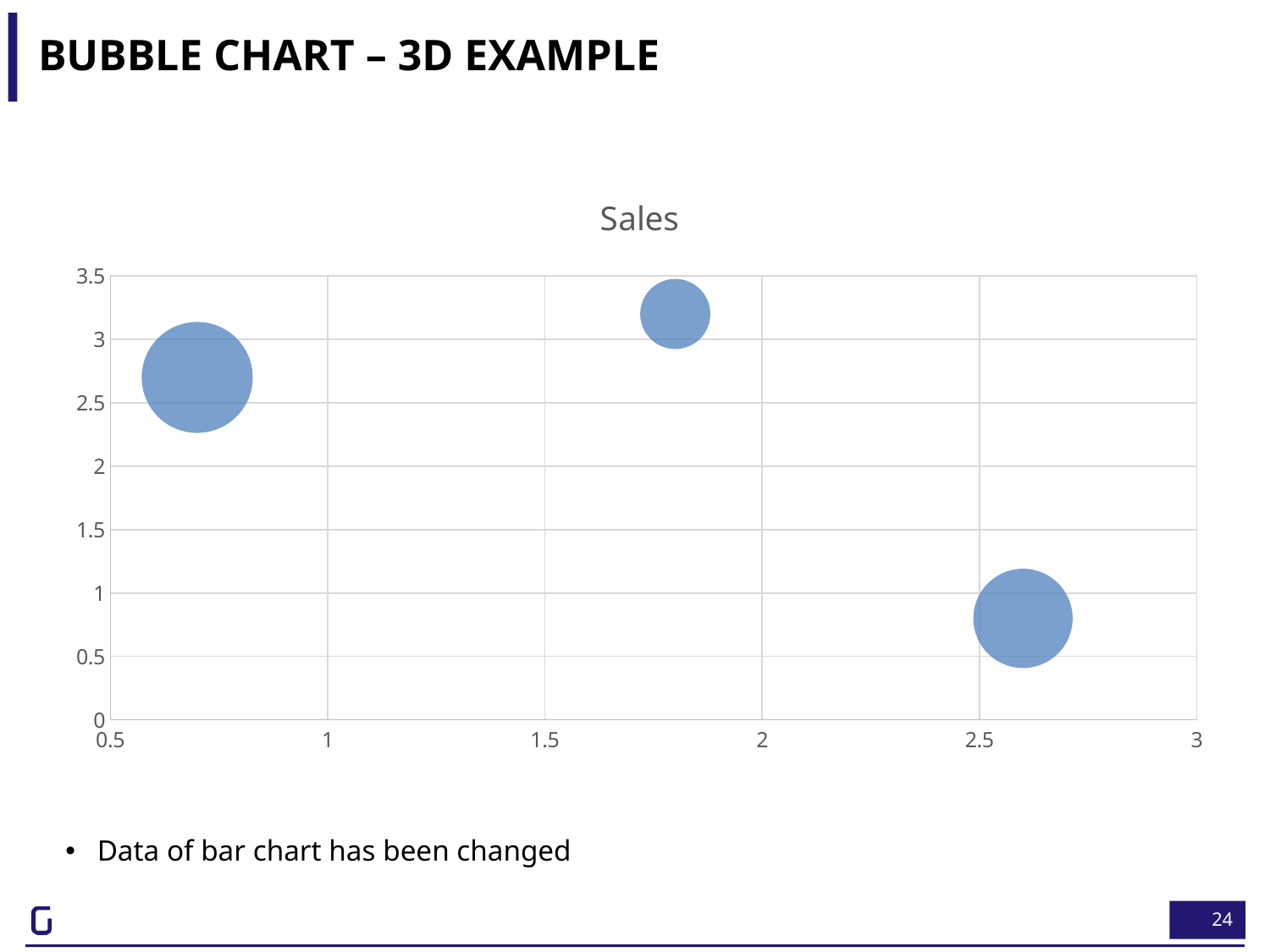
Which bubble is larger in size, the leftmost bubble or the middle bubble? The leftmost bubble Is the x-axis value of the leftmost bubble greater or less than 1? less Is the y-axis value of the topmost bubble greater or less than 3? greater How many bubbles are plotted on the chart? 3 What is the highest value shown on the y-axis? 3.5 Which bubble has the lowest y-axis value: the leftmost, the middle, or the rightmost? The rightmost What is the title of the chart? Sales What kind of chart is shown on the slide? Bubble chart Is the x-axis value of the rightmost bubble greater or less than 2.5? greater Which bubble has the highest y-axis value: the leftmost, the middle, or the rightmost? The middle